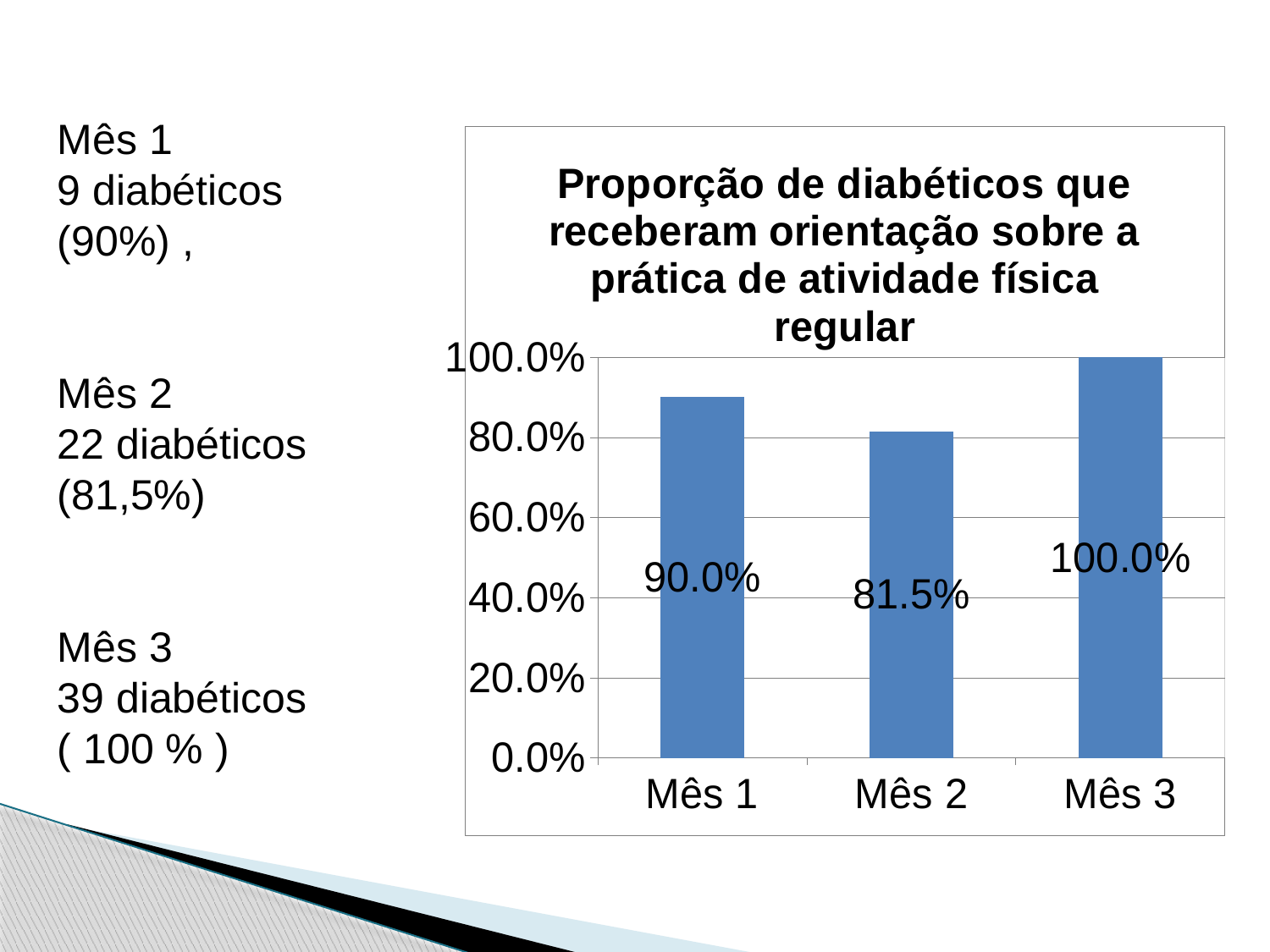
Is the value for Mês 2 greater or less than 80.0%? greater What is the title of the chart? Proporção de diabéticos que receberam orientação sobre a prática de atividade física regular What is the value for Mês 3? 100.0% Which month has the highest value? Mês 3 What is the value for Mês 2? 81.5% What is the difference between the values for Mês 3 and Mês 2? 18.5% How many categories are shown on the x axis? 3 Which is larger, the value for Mês 1 or the value for Mês 2? Mês 1 What is the difference between the values for Mês 1 and Mês 2? 8.5% What is the value for Mês 1? 90.0% What kind of chart is shown on the slide? bar chart Which month has the lowest value? Mês 2